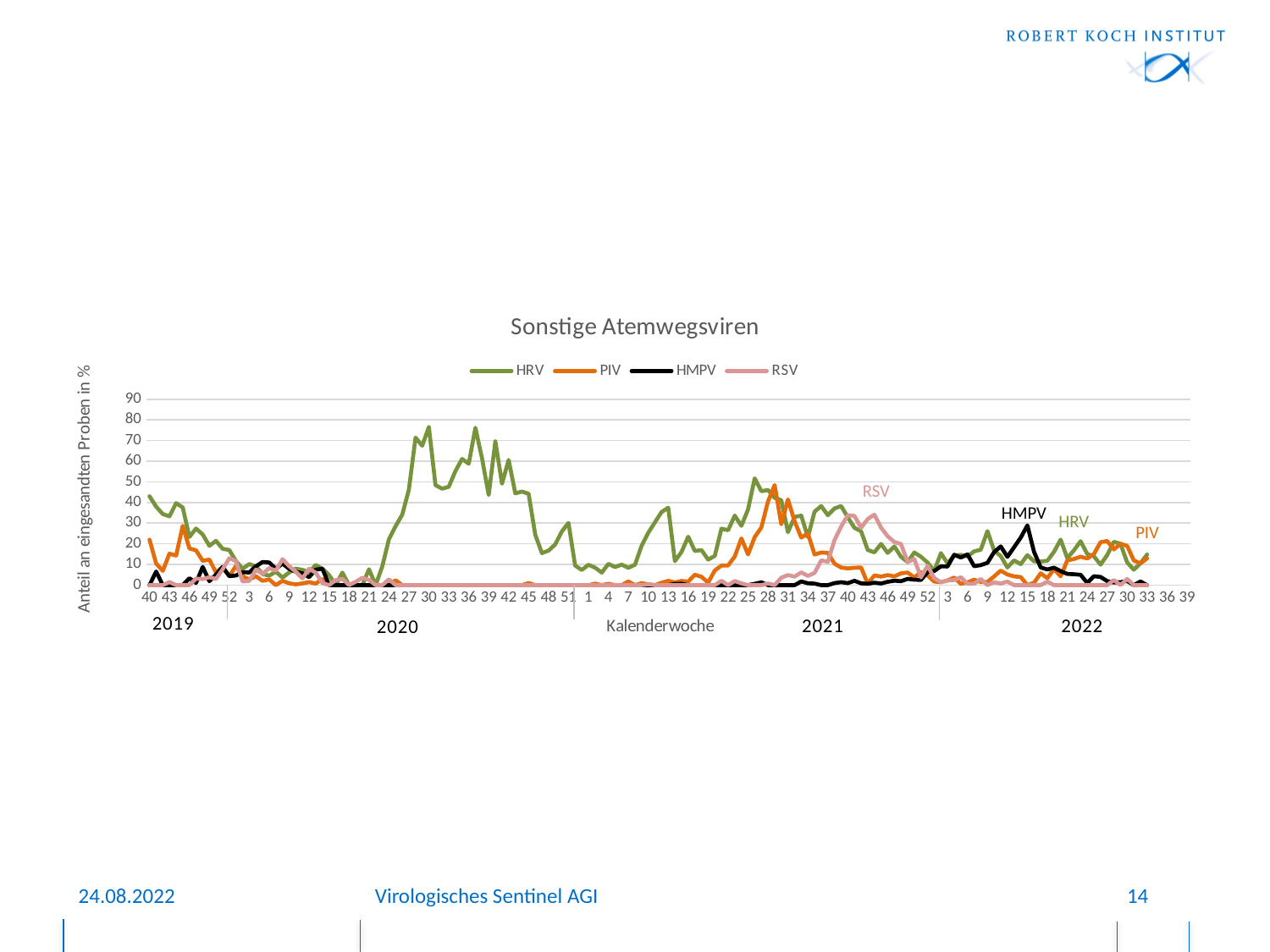
Is the peak value of PIV in 2021 greater or less than 40? greater How many series does the legend of the chart list? 4 Which series has the higher peak in 2021, PIV or RSV? PIV Is the peak value of RSV in 2021 greater or less than 20? greater Which series are listed in the chart legend? HRV, PIV, HMPV, RSV What kind of chart is shown on the slide? line chart Is the peak value of HMPV in 2022 greater or less than 20? greater What is the title of the chart? Sonstige Atemwegsviren How many years are marked along the x axis of the chart? 4 Which series reaches the highest value anywhere in the chart? HRV